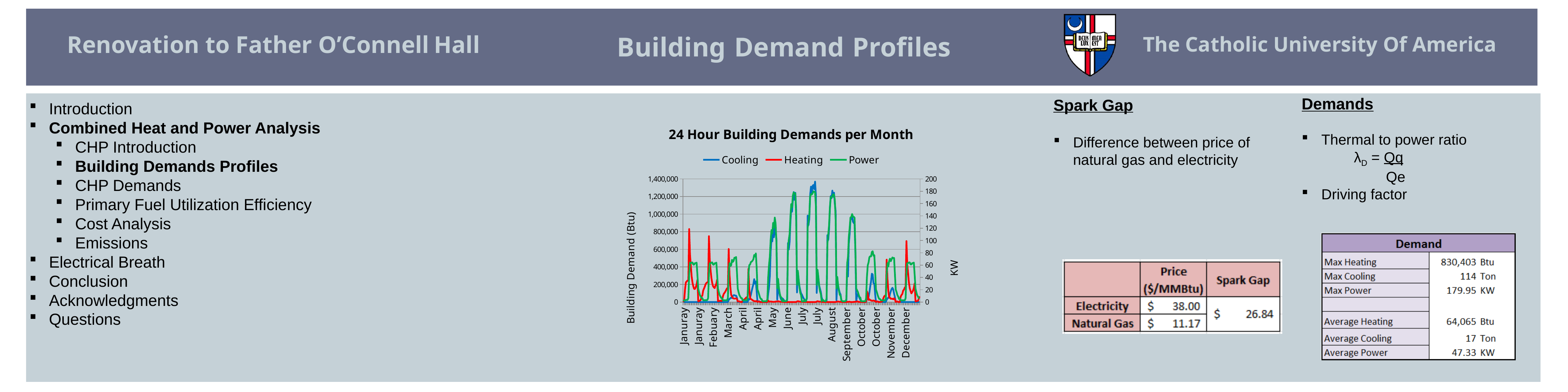
What kind of chart is '24 Hour Building Demands per Month'? line chart Which is larger, the peak Power value in January or the peak Power value in July? July What are the three series named in the legend of the chart? Cooling, Heating, Power How many series does the legend of the '24 Hour Building Demands per Month' chart list? 3 What is the label of the left vertical axis of the chart? Building Demand (Btu) Does the peak Power demand generally rise or fall from January to July? rise Is the Heating value in July greater or less than 200,000 Btu? less Which is larger, the peak Heating value in January or the peak Heating value in July? January Is the peak Heating value in January greater or less than 600,000 Btu? greater Is the peak Cooling value in July greater or less than 1,200,000 Btu? greater Does the peak Heating demand generally rise or fall from January to July? fall